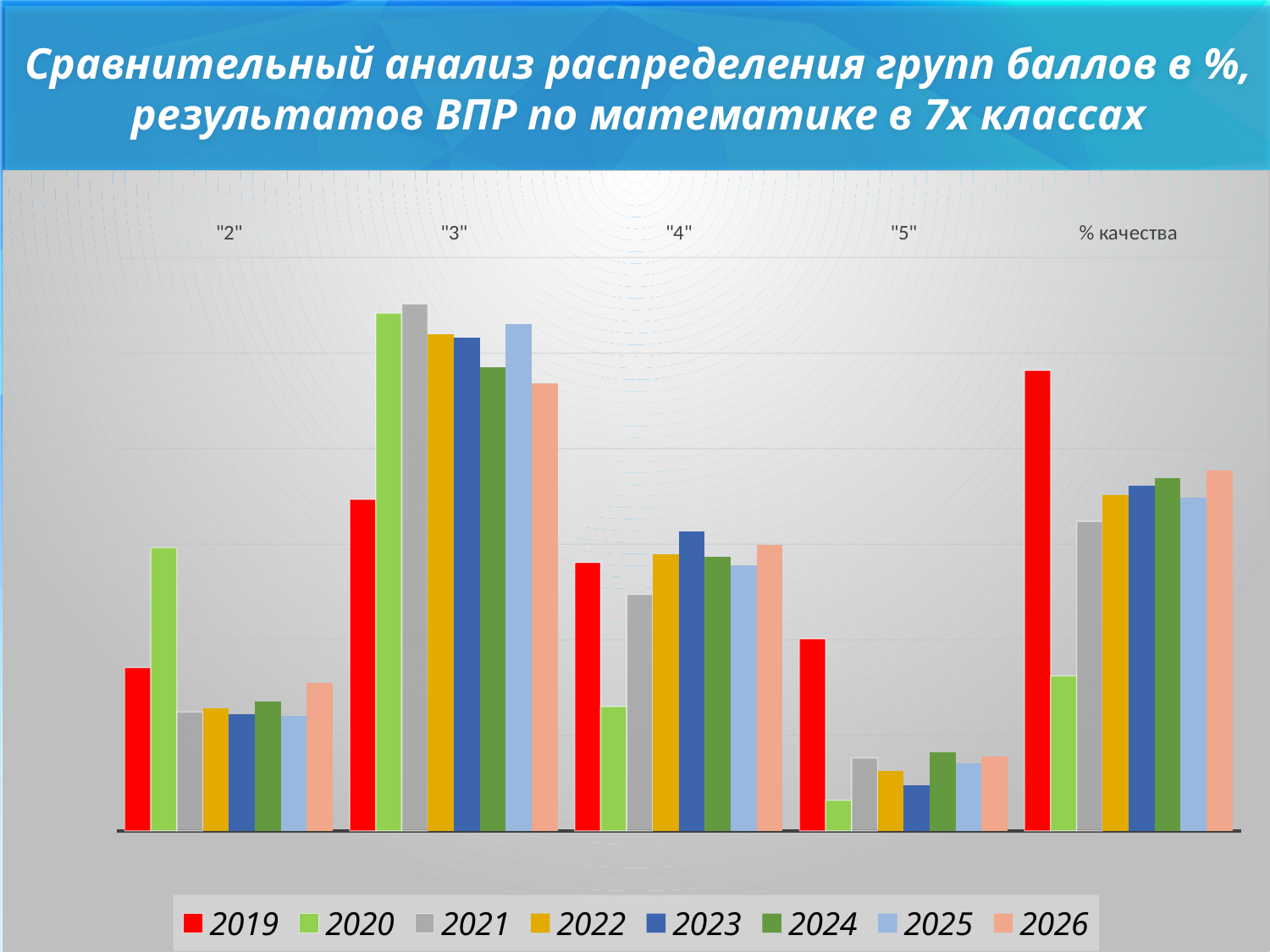
In the "% качества" category, which year has the lowest bar? 2020 In the "3" category, which year has the lowest bar? 2019 In the "4" category, which year has the lowest bar? 2020 What kind of chart is shown on the slide? bar chart In the "4" category, which year has the highest bar? 2023 How many series does the legend list? 8 In the "2" category, which year has the highest bar? 2020 In the "5" category, which year has the highest bar? 2019 In the "3" category, which is larger: the bar for 2019 or the bar for 2020? 2020 Which colour represents the 2019 series in the legend? red How many categories are shown along the x axis? 5 In the "% качества" category, which is larger: the bar for 2019 or the bar for 2026? 2019